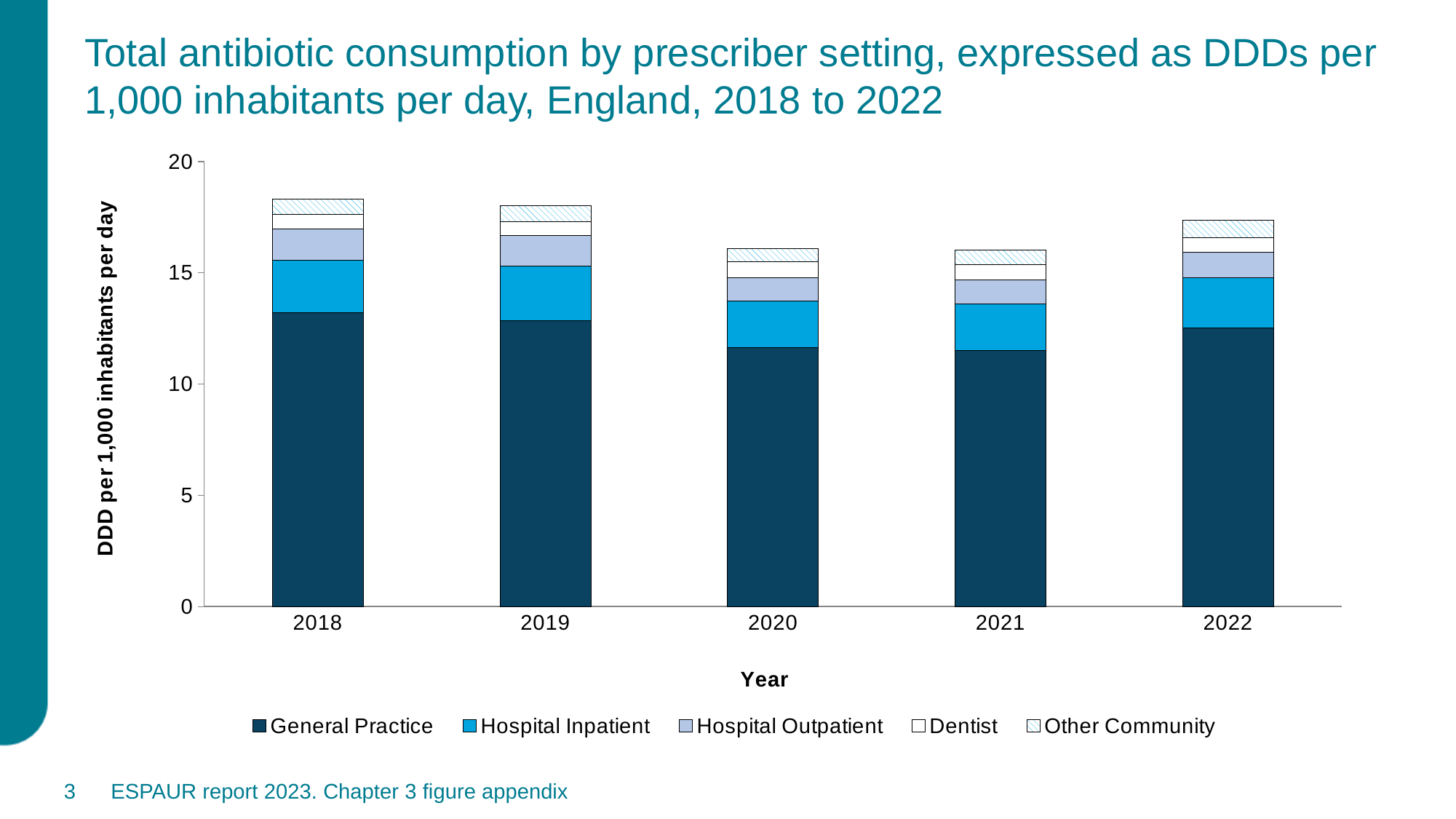
How many series does the chart's legend list? 5 What kind of chart is shown on the slide? Stacked bar chart Is the total height of the 2018 bar greater or less than 15? greater Is the General Practice value for 2018 greater or less than 10? greater What is the label on the y axis of the chart? DDD per 1,000 inhabitants per day Which series is shown at the bottom of each stacked bar, in dark blue? General Practice Which year has the larger General Practice value, 2018 or 2021? 2018 How many years are shown on the x axis of the chart? 5 Which year has the larger total bar, 2018 or 2020? 2018 Do the total bar heights rise or fall from 2018 to 2020? fall Is the total height of the 2020 bar greater or less than 20? less